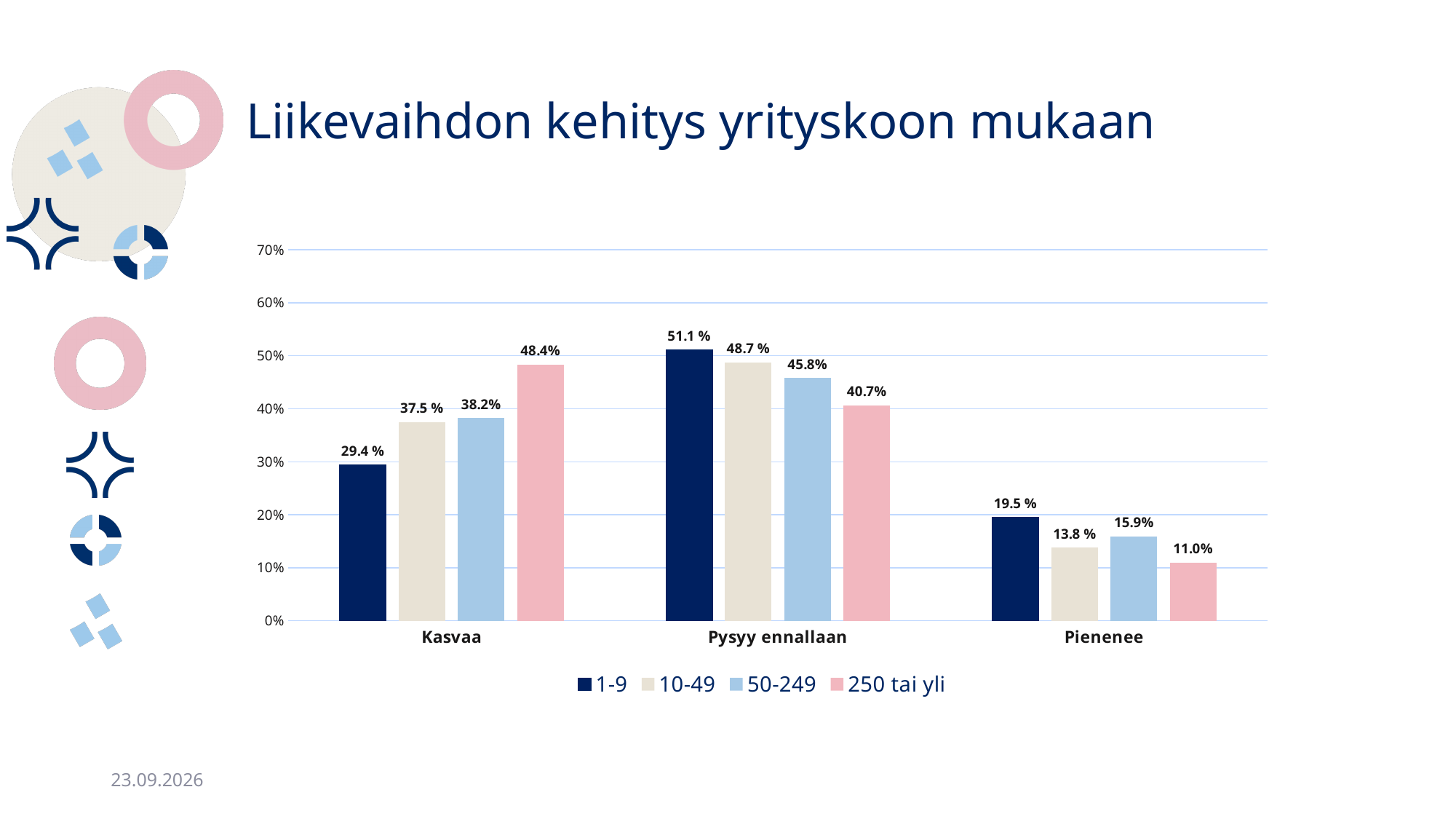
Which series has the lowest value in the Pienenee category? 250 tai yli How many categories are shown on the x axis? 3 What is the value for the 50-249 series in the Pienenee category? 15.9% Which series has the highest value in the Kasvaa category? 250 tai yli What is the value for the 250 tai yli series in the Pysyy ennallaan category? 40.7% Is the value for 10-49 in the Pienenee category greater or less than 20%? less Which category has the highest value for the 1-9 series? Pysyy ennallaan How many series does the legend list? 4 Which is larger in the Pysyy ennallaan category: the 1-9 value or the 50-249 value? 1-9 What is the value for the 1-9 series in the Kasvaa category? 29.4 % What is the difference between the 250 tai yli and 1-9 values in the Kasvaa category? 19.0 percentage points What type of chart is shown on the slide? bar chart